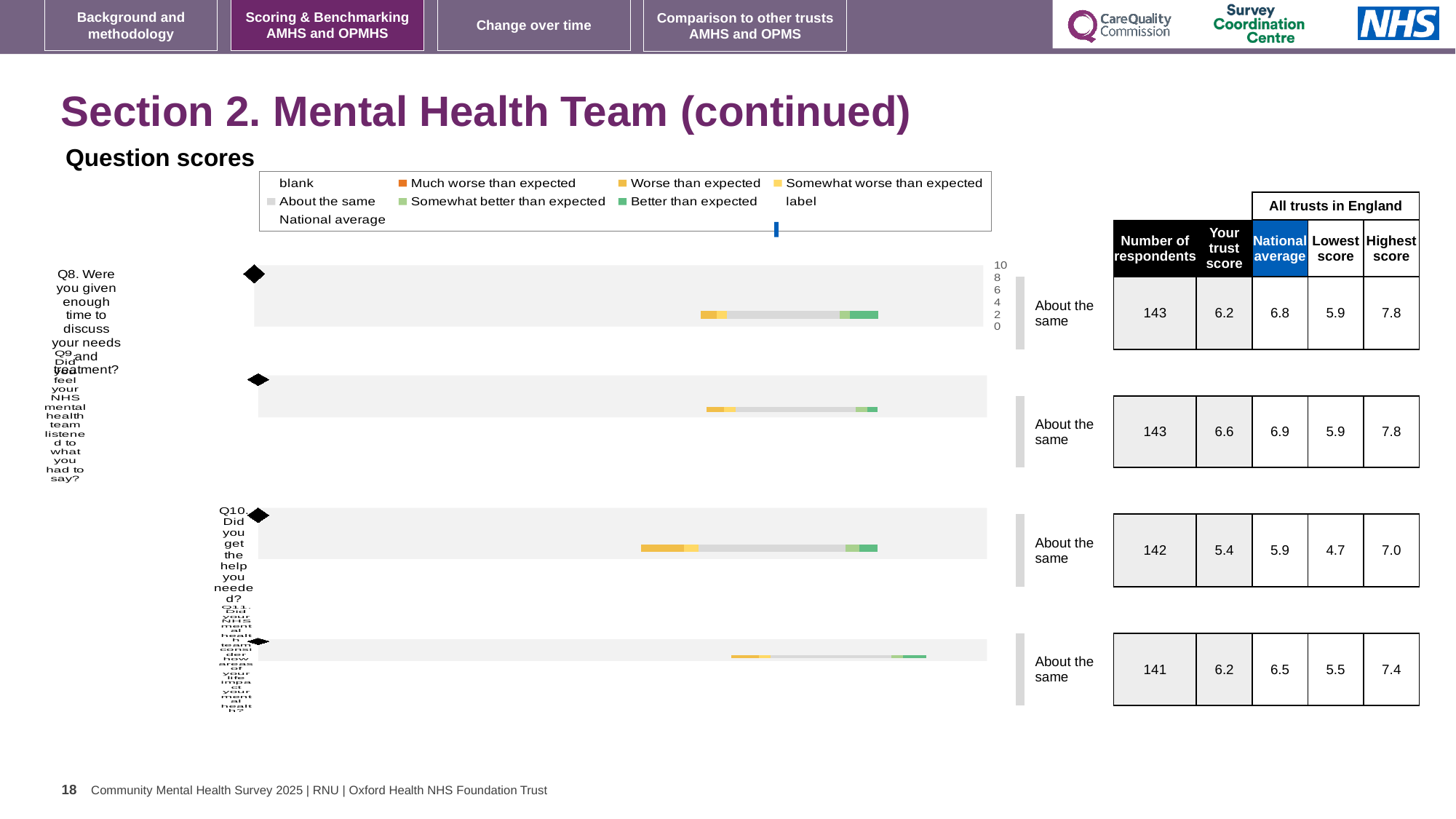
Which legend entry is shown in grey? About the same In the table beside the Q10 chart, what is the difference between the highest score and the lowest score? 2.3 Which colour does the legend use for 'Much worse than expected'? orange In the table beside the Q10 chart, what is the national average? 5.9 How many question charts are shown on the slide? 4 In the table beside the Q9 chart, which is larger: your trust score or the national average? National average What benchmark category is shown for all four questions? About the same What kind of chart is used to show the Q8 question score? bar chart Which question's table row has the lowest 'Your trust score'? Q10 In the table beside the Q8 chart, what is the 'Your trust score' value? 6.2 How many entries does the legend above the charts list? 9 In the table beside the Q9 chart, how many respondents are listed? 143